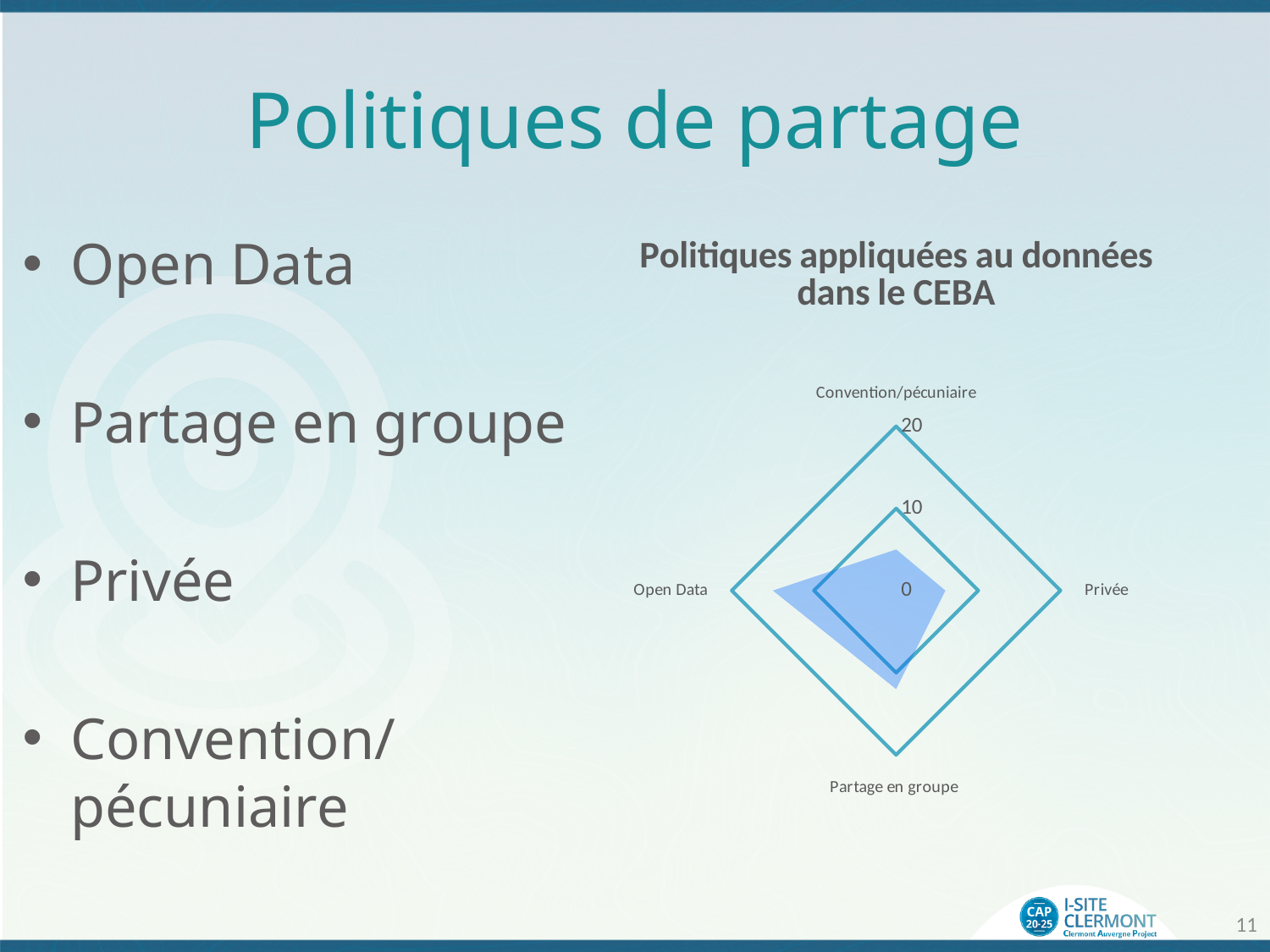
Is the value for Open Data greater or less than 10? greater Is the value for Open Data greater or less than 20? less Which category has the highest value in the radar chart? Open Data Which is larger, the value for Open Data or the value for Privée? Open Data What is the maximum value shown on the radar chart's axis scale? 20 Is the value for Privée greater or less than 10? less What is the title of the chart on the slide? Politiques appliquées au données dans le CEBA How many categories (axes) does the radar chart have? 4 Which is larger, the value for Partage en groupe or the value for Privée? Partage en groupe What kind of chart is shown on the slide? Radar chart Which is larger, the value for Open Data or the value for Partage en groupe? Open Data